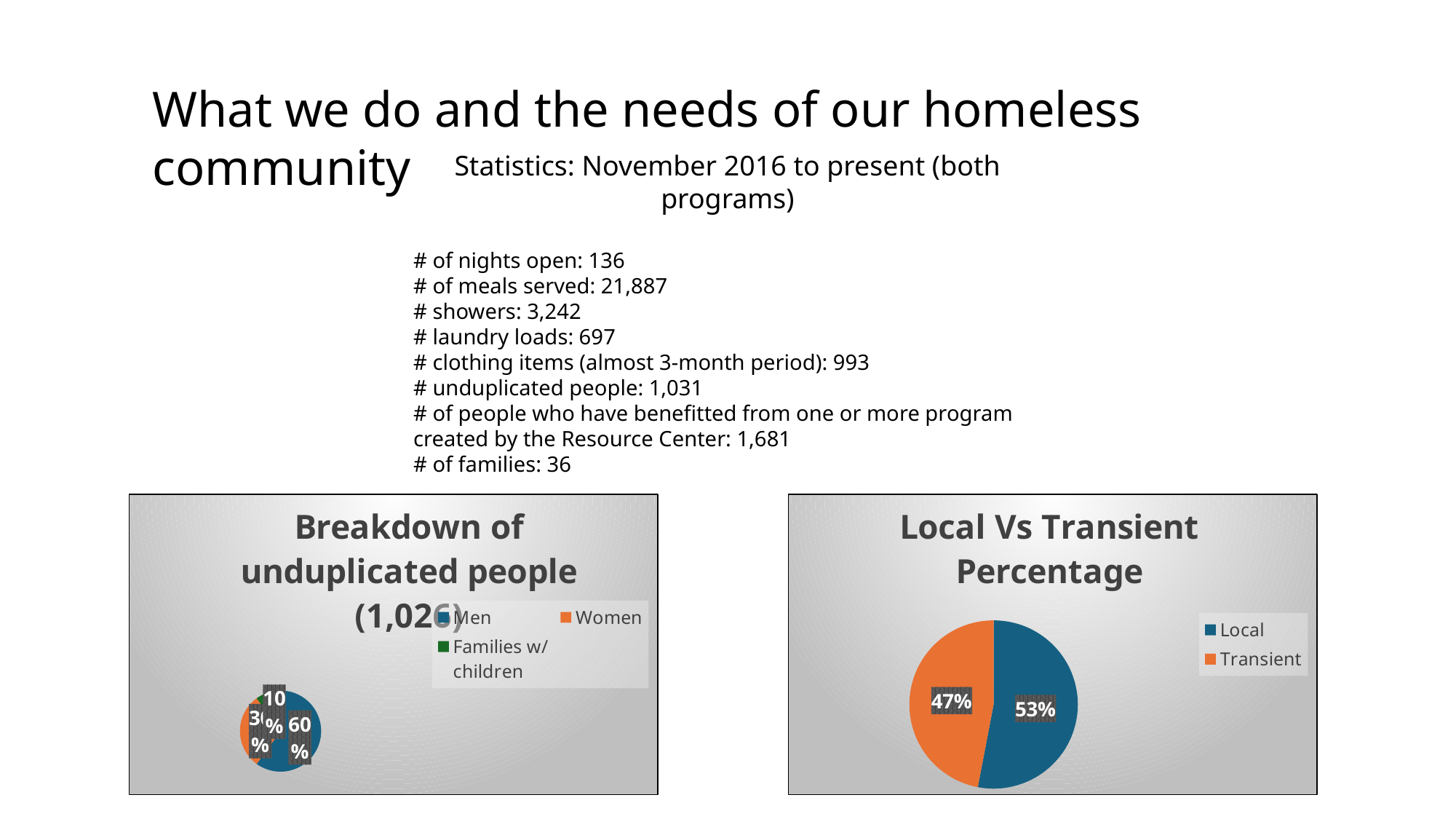
How many entries does the legend of the 'Local Vs Transient Percentage' chart list? 2 In the 'Local Vs Transient Percentage' chart, what is the difference between the Local and Transient values? 6% How many entries does the legend of the 'Breakdown of unduplicated people' chart list? 3 In the 'Breakdown of unduplicated people' chart, what is the value for Men? 60% In the 'Local Vs Transient Percentage' chart, what is the value for Local? 53% What colour represents Transient in the 'Local Vs Transient Percentage' chart? orange What kind of chart is the 'Local Vs Transient Percentage' chart? pie chart What kind of chart is the 'Breakdown of unduplicated people' chart? pie chart In the 'Local Vs Transient Percentage' chart, what is the value for Transient? 47% In the 'Breakdown of unduplicated people' chart, which category has the smallest slice? Families w/ children In the 'Breakdown of unduplicated people' chart, which category has the largest slice? Men In the 'Local Vs Transient Percentage' chart, which is larger, Local or Transient? Local